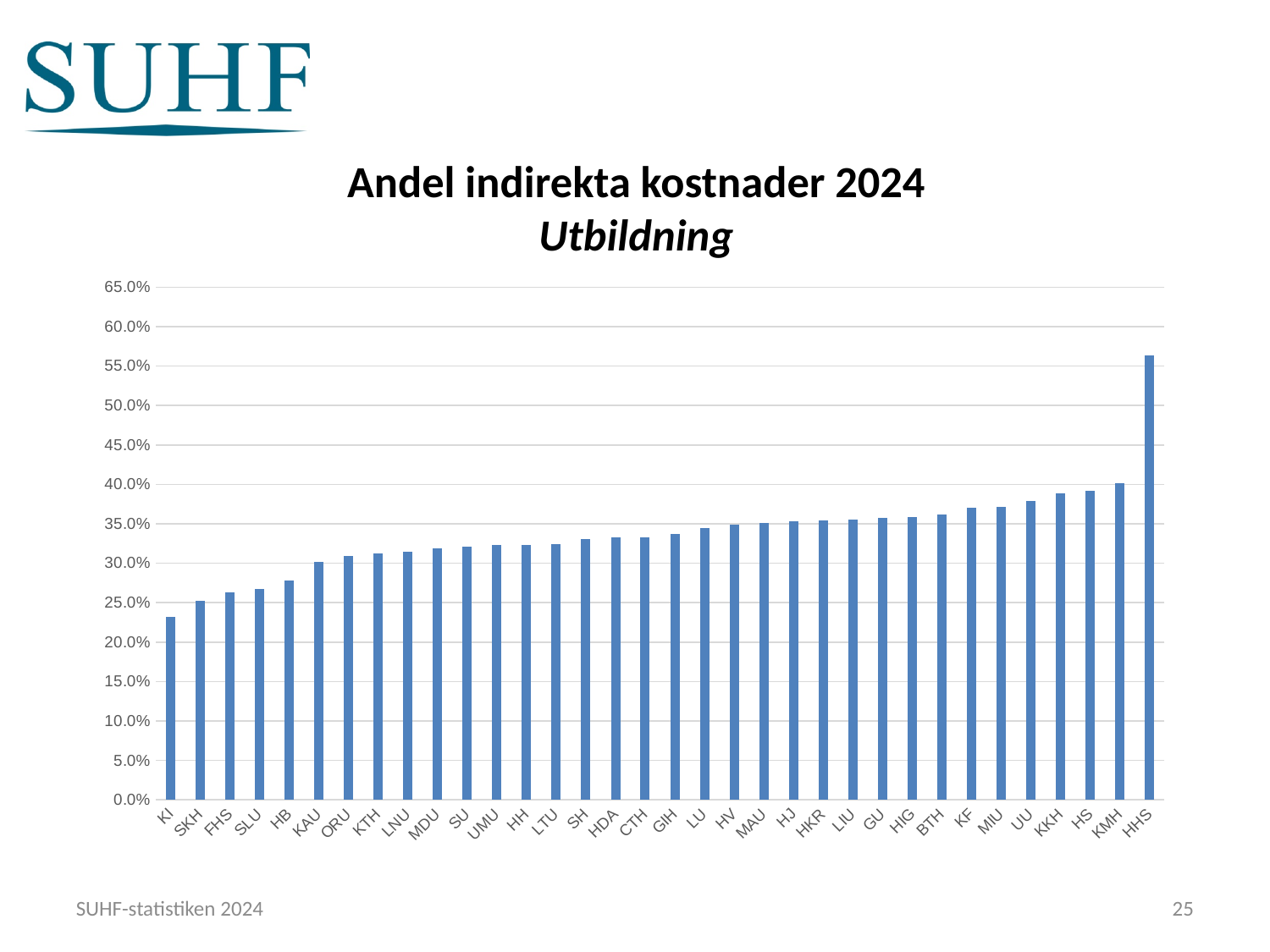
Is the value for HB greater or less than 30.0%? less What kind of chart is shown on the slide? bar chart Is the value for KI greater or less than 25.0%? less How many categories are plotted on the x axis? 34 Is the value for HS greater or less than 40.0%? less Do the values generally rise or fall from left to right along the x axis? rise Which category has the lowest value? KI Which is larger, the value for HHS or the value for KMH? HHS What is the title of the chart? Andel indirekta kostnader 2024 Utbildning Which category has the highest value? HHS